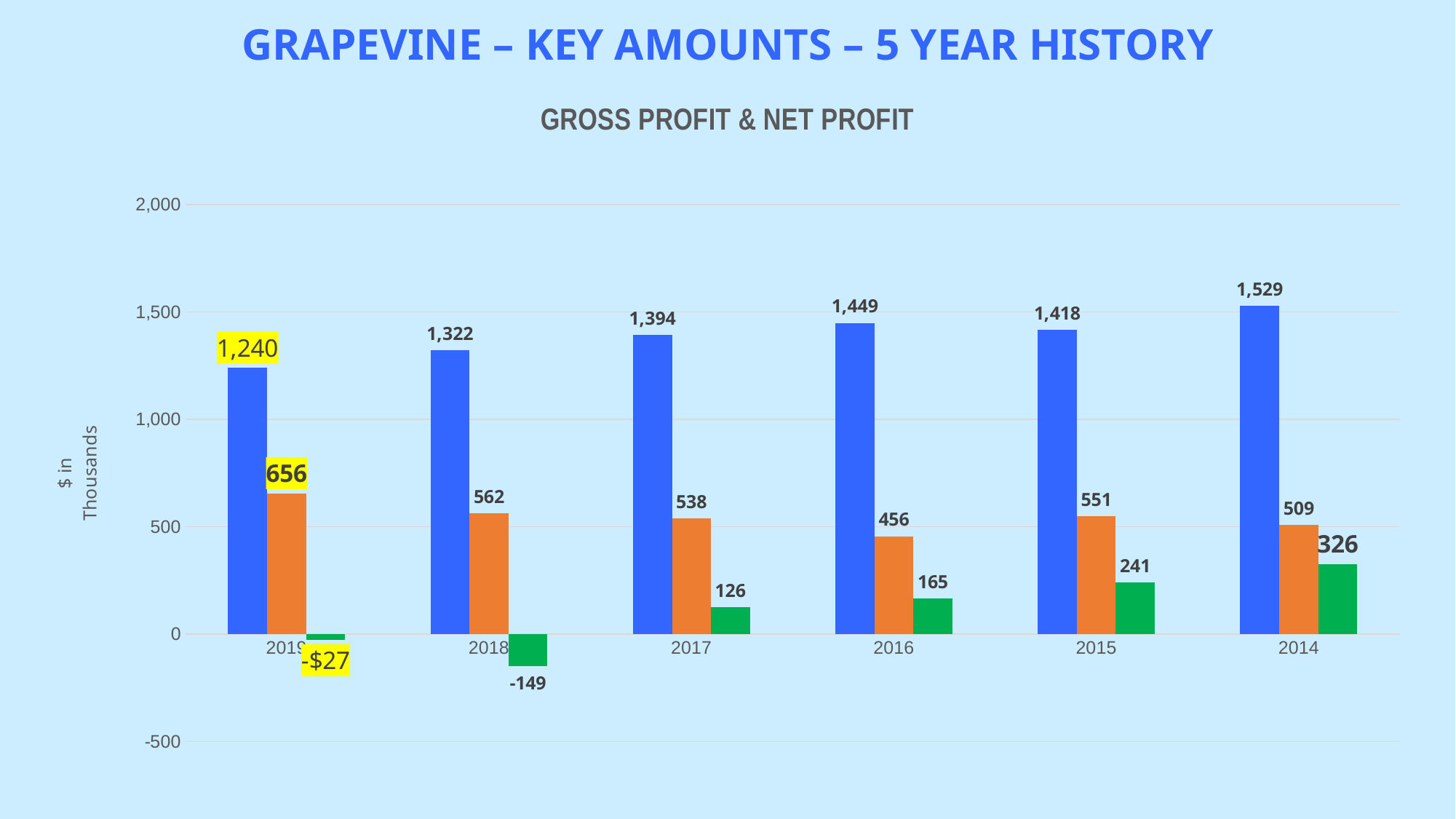
Which is larger, the orange bar for 2015 or the orange bar for 2016? 2015 What is the title of the chart? GROSS PROFIT & NET PROFIT What is the value of the blue bar for 2014? 1,529 What kind of chart is shown on the slide? bar chart Which year has the lowest green bar? 2018 Do the green bar values rise or fall from 2014 to 2019 (reading right to left)? fall What is the difference between the blue bar values for 2014 and 2019? 289 What is the value of the green bar for 2018? -149 How many years are shown on the x axis? 6 Is the value of the blue bar for 2016 greater or less than 1,000? greater What is the value of the orange bar for 2019? 656 Which year has the highest blue bar? 2014